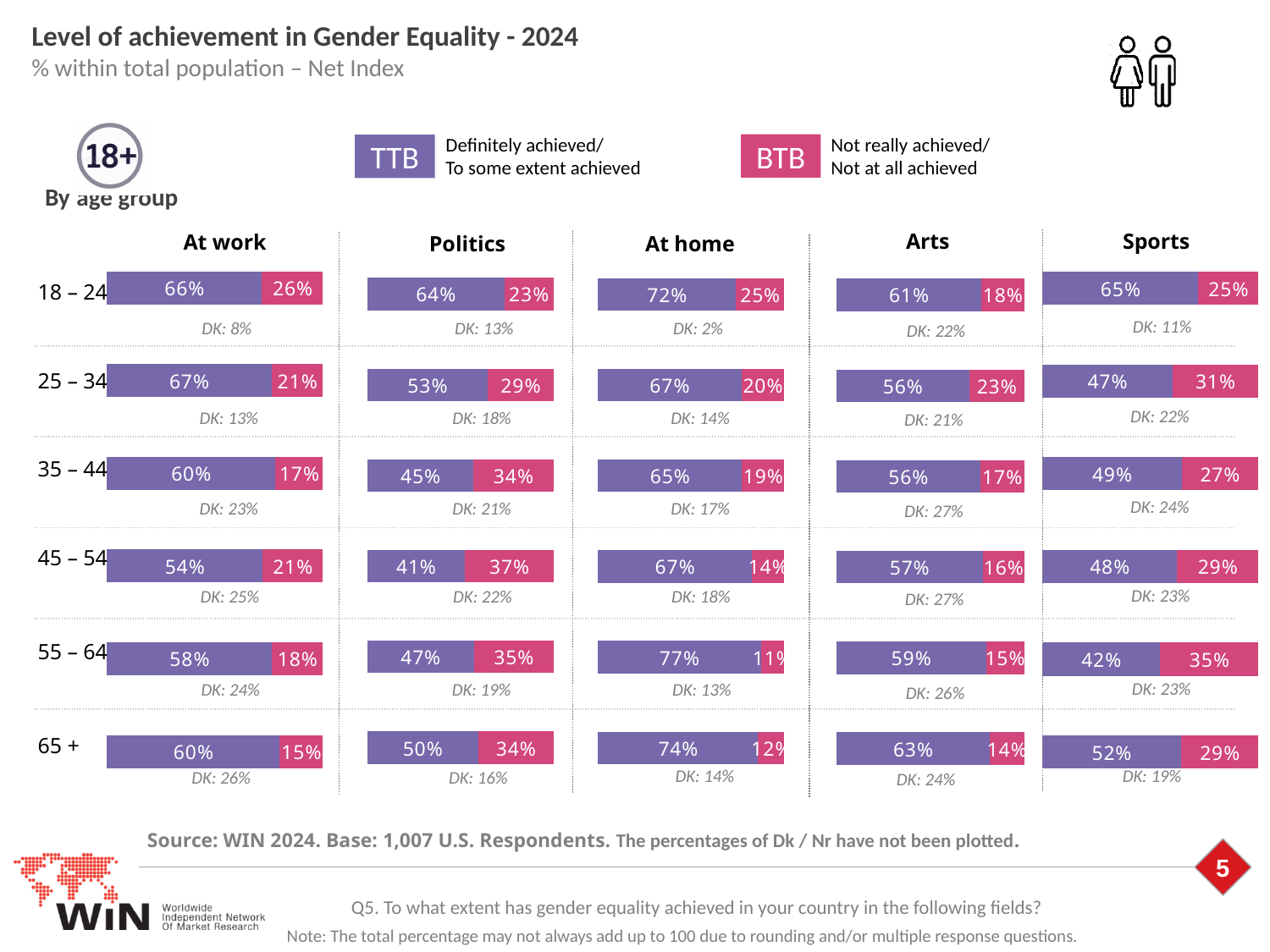
What kind of chart is used to show the results for each field? Stacked bar chart How many series does the legend list? 2 In the Sports chart, what is the BTB value for the 25 – 34 age group? 31% In the Politics chart, what is the total of the TTB and BTB values for the 25 – 34 age group? 82% In the At work chart, what is the difference between the TTB and BTB values for the 35 – 44 age group? 43% In the Politics chart, what is the BTB value for the 45 – 54 age group? 37% In the At home chart, what is the TTB value for the 55 – 64 age group? 77% In the Sports chart, is the TTB value for the 18 – 24 age group larger than the TTB value for the 55 – 64 age group? Yes In the Politics chart, which age group has the lowest TTB value? 45 – 54 How many age groups are shown in each chart? 6 In the Arts chart, which age group has the highest TTB value? 65 + In the At work chart, what is the TTB value for the 18 – 24 age group? 66%